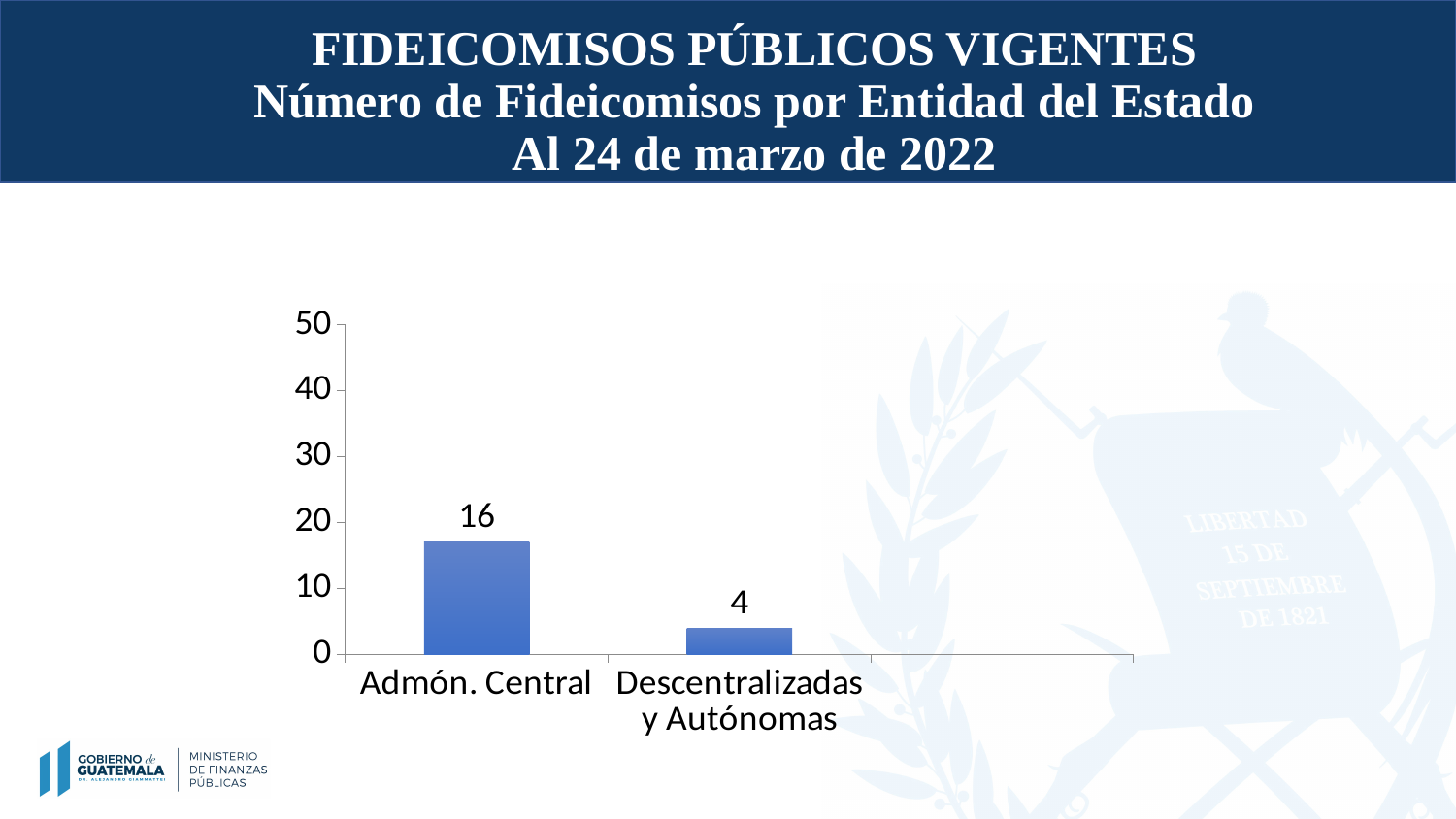
Which category has the highest value? Admón. Central What kind of chart is shown on the slide? bar chart Is the value for Admón. Central greater or less than 10? greater Which category has the lowest value? Descentralizadas y Autónomas What is the value for Admón. Central? 16 What is the difference between the values for Admón. Central and Descentralizadas y Autónomas? 12 What is the highest value shown on the vertical axis of the chart? 50 What is the value for Descentralizadas y Autónomas? 4 Is the value for Descentralizadas y Autónomas greater or less than 10? less How many categories are shown on the chart? 2 Which is larger, the value for Admón. Central or the value for Descentralizadas y Autónomas? Admón. Central What is the total of the two values shown on the chart? 20